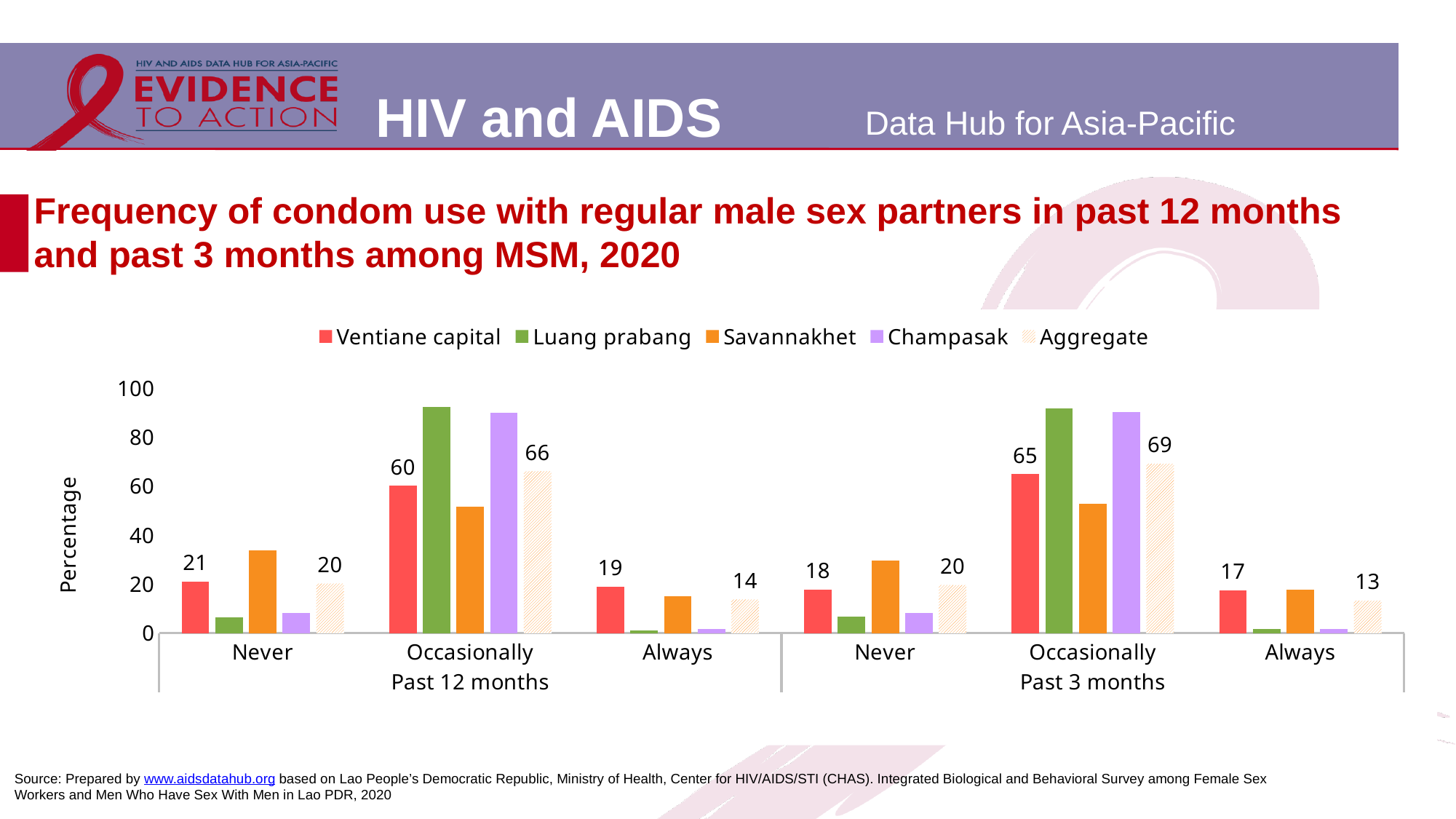
Among the Aggregate values shown, which category and period has the highest value? Occasionally, Past 3 months What is the Ventiane capital value for Never in the past 3 months? 18 What kind of chart is shown on the slide? Bar chart How many series does the legend list? 5 What is the difference between the Aggregate and Ventiane capital values for Occasionally in the past 12 months? 6 Is the Luang prabang value for Occasionally in the past 12 months greater or less than 80? greater Is the Savannakhet value for Never in the past 12 months greater or less than 40? less Which is larger for Always in the past 3 months: Ventiane capital or Aggregate? Ventiane capital What is the Aggregate value for Occasionally in the past 3 months? 69 What is the label on the vertical axis? Percentage What is the Aggregate value for Always in the past 12 months? 14 What is the Ventiane capital value for Occasionally in the past 12 months? 60